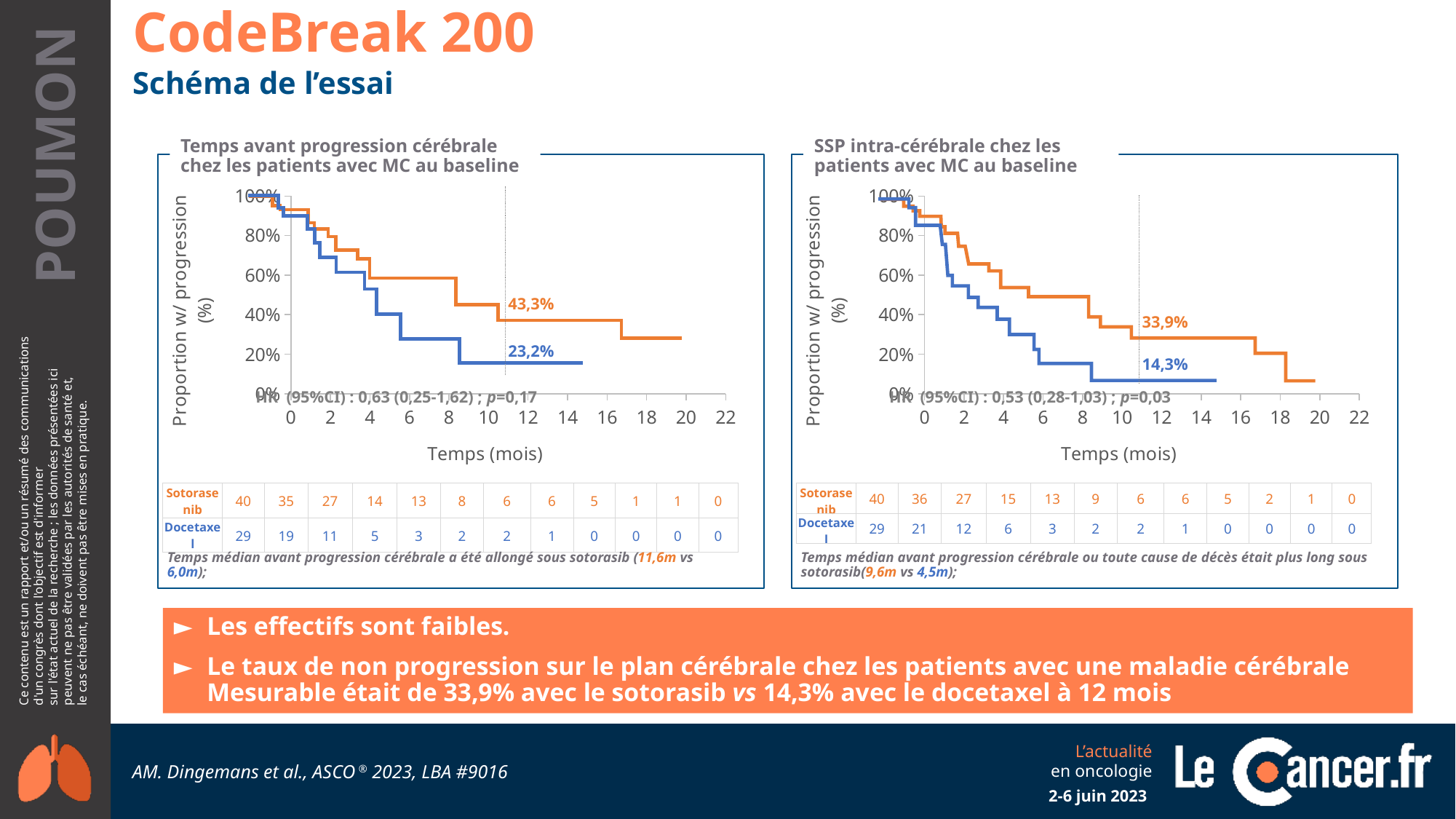
What kind of chart is used on this slide to show proportion without progression over time? Line chart What is the x-axis label of both charts? Temps (mois) In the left chart (Temps avant progression cérébrale), how many sotorasib patients are at risk at time 0 according to the table below the chart? 40 In the right chart (SSP intra-cérébrale), what is the difference between the labelled sotorasib and docetaxel values? 19,6% In the left chart (Temps avant progression cérébrale), what is the difference between the labelled sotorasib and docetaxel values? 20,1% In the right chart (SSP intra-cérébrale), which curve has the higher labelled value, sotorasib or docetaxel? Sotorasib In the left chart (Temps avant progression cérébrale), what value is labelled on the blue docetaxel curve at the dotted vertical line? 23,2% In the left chart (Temps avant progression cérébrale), do the curves rise or fall as time increases? Fall In the left chart (Temps avant progression cérébrale), what value is labelled on the orange sotorasib curve at the dotted vertical line? 43,3% In the right chart (SSP intra-cérébrale), what value is labelled on the blue docetaxel curve? 14,3% In the right chart (SSP intra-cérébrale), how many docetaxel patients are at risk at the second time point according to the table below the chart? 21 In the right chart (SSP intra-cérébrale), what value is labelled on the orange sotorasib curve? 33,9%